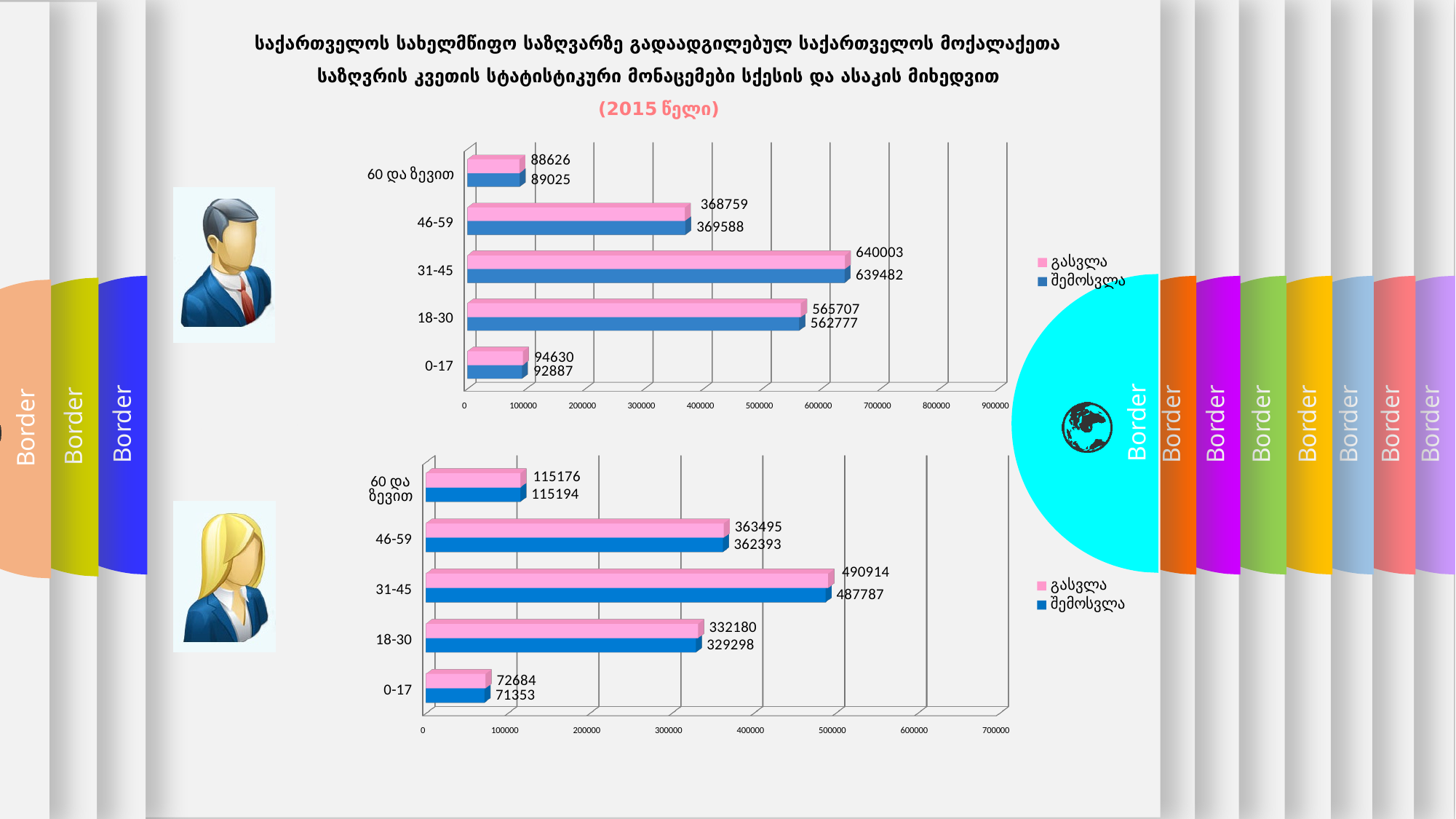
In the top chart, what is the გასვლა value for the 31-45 age group? 640003 In the bottom chart, what is the შემოსვლა value for the 0-17 age group? 71353 In the bottom chart, what is the difference between the გასვლა and შემოსვლა values for the 31-45 age group? 3127 In the bottom chart, which is larger: the გასვლა value for 18-30 or the გასვლა value for 46-59? 46-59 In the top chart, what is the შემოსვლა value for the 18-30 age group? 562777 How many age groups are shown in the top chart? 5 In the bottom chart, which age group has the lowest შემოსვლა value? 0-17 What type of chart is the top chart? Bar chart In the bottom chart, what is the გასვლა value for the 46-59 age group? 363495 In the top chart, which age group has the highest გასვლა value? 31-45 How many series does the legend of the bottom chart list? 2 In the top chart, what is the difference between the გასვლა and შემოსვლა values for the 18-30 age group? 2930